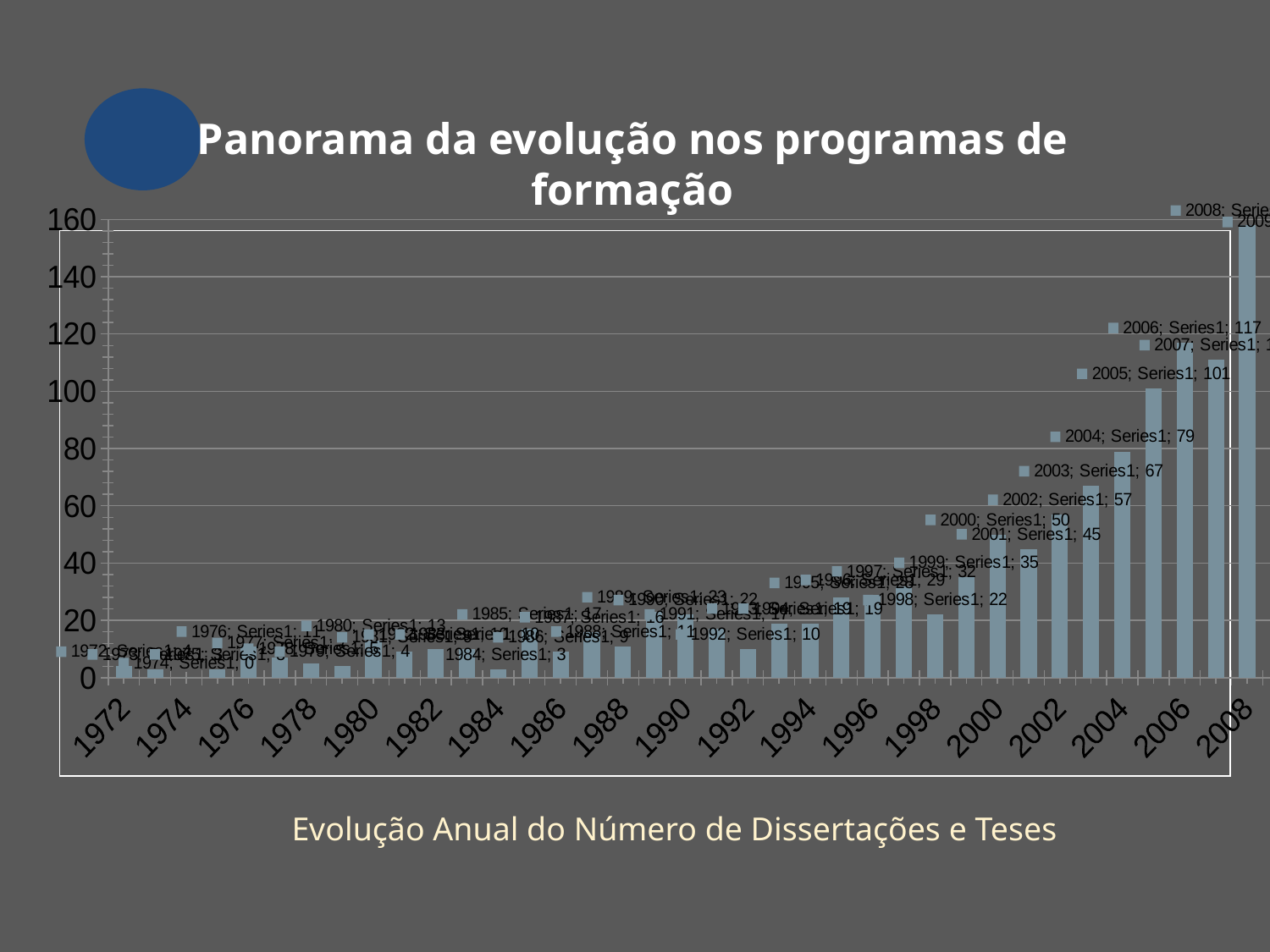
What is the value for 2000? 50 What kind of chart is shown on the slide? bar chart What is the value for 1999? 35 What is the value for 2005? 101 Which year has the lowest value? 1974 What is the value for 2004? 79 What is the difference between the values for 2006 and 2005? 16 What is the value for 2003? 67 Is the value for 2009 greater or less than 140? greater What is the value for 2006? 117 Which year has the larger value, 2000 or 2001? 2000 Do the values generally rise or fall from 1972 to 2009? rise